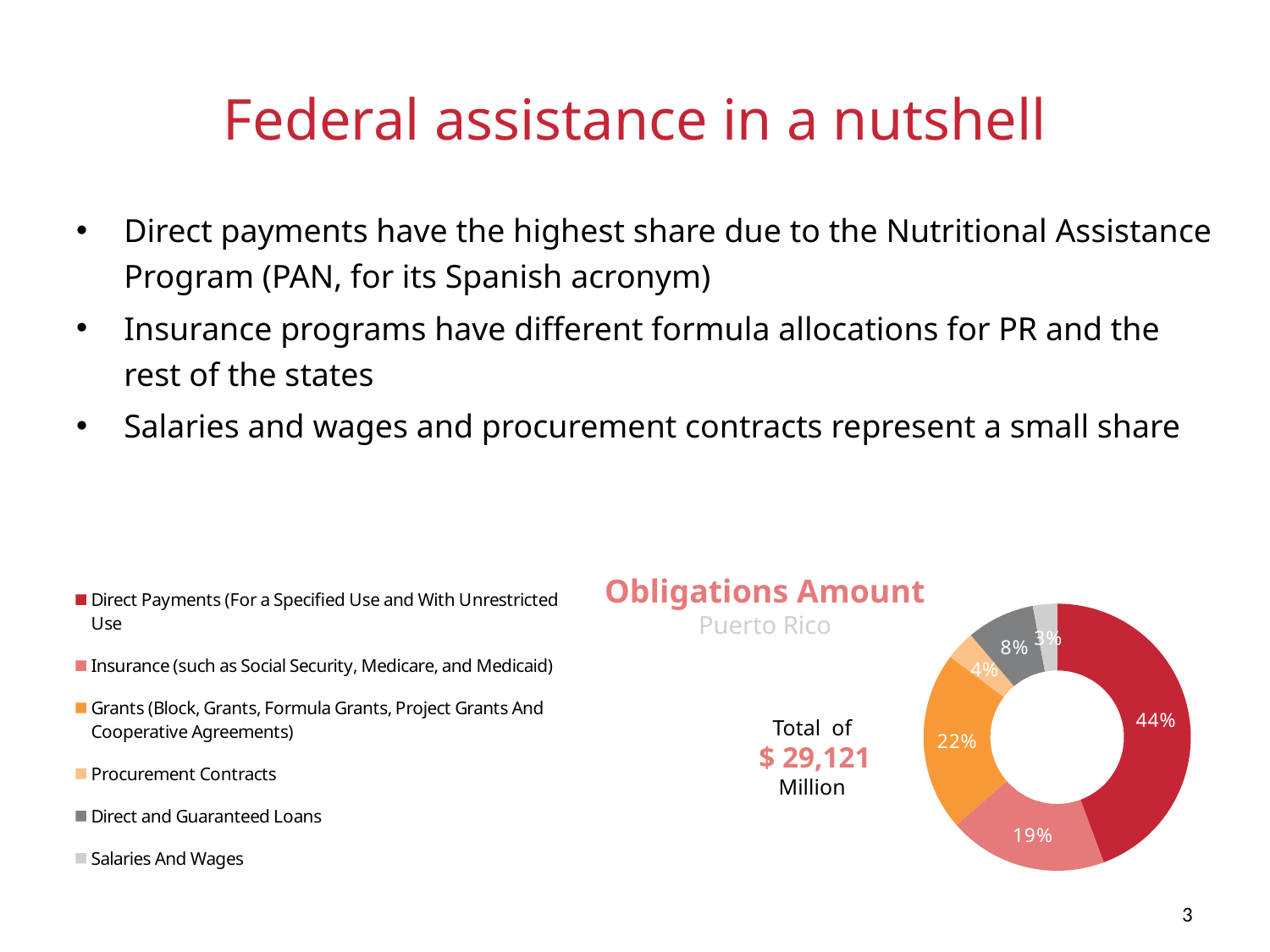
What share of obligations is Salaries And Wages? 3% Which category has the largest share of obligations? Direct Payments What share of obligations is Insurance? 19% What kind of chart is shown on the slide? Donut (pie) chart What share of obligations is Direct and Guaranteed Loans? 8% What is the title of the chart? Obligations Amount What share of obligations is Direct Payments? 44% How many categories does the legend list? 6 What share of obligations is Grants? 22% What share of obligations is Procurement Contracts? 4% Which category has the smallest share of obligations? Salaries And Wages What is the total obligations amount shown in the centre of the chart? $ 29,121 Million